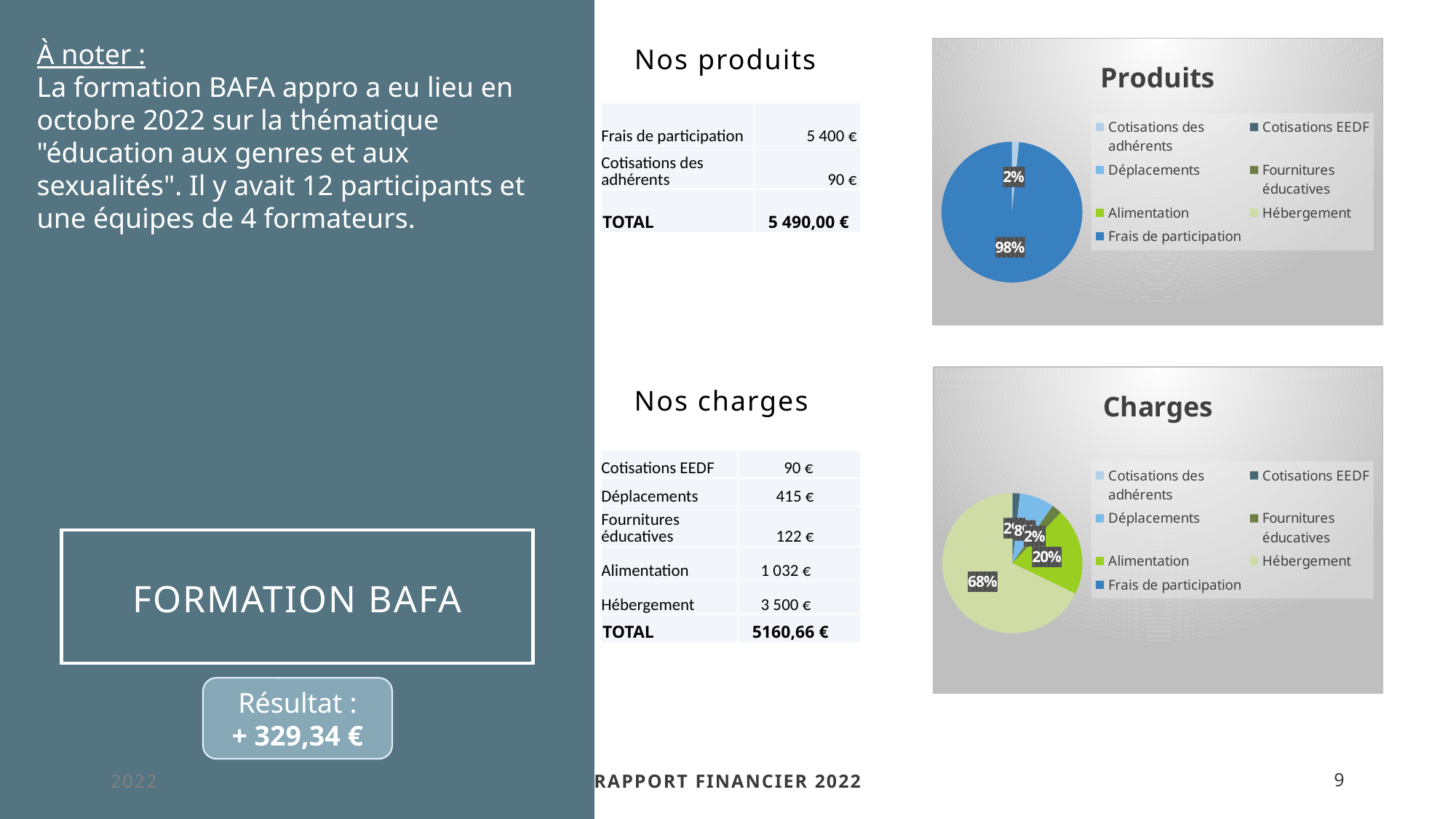
In the 'Charges' chart, what share of the pie is Alimentation? 20% What is the title of the top chart on the slide? Produits In the 'Produits' chart, what is the difference in percentage points between the Frais de participation slice and the Cotisations des adhérents slice? 96 percentage points In the 'Produits' chart, what share of the pie is Cotisations des adhérents? 2% In the 'Charges' chart, what share of the pie is Hébergement? 68% In the 'Charges' chart, which slice is larger: Hébergement or Alimentation? Hébergement In the 'Produits' chart, which category has the largest slice? Frais de participation How many entries does the legend of the 'Charges' chart list? 7 What kind of chart is the 'Produits' chart? Pie chart In the 'Charges' chart, what is the difference in percentage points between the Hébergement slice and the Alimentation slice? 48 percentage points In the 'Charges' chart, which category has the largest slice? Hébergement